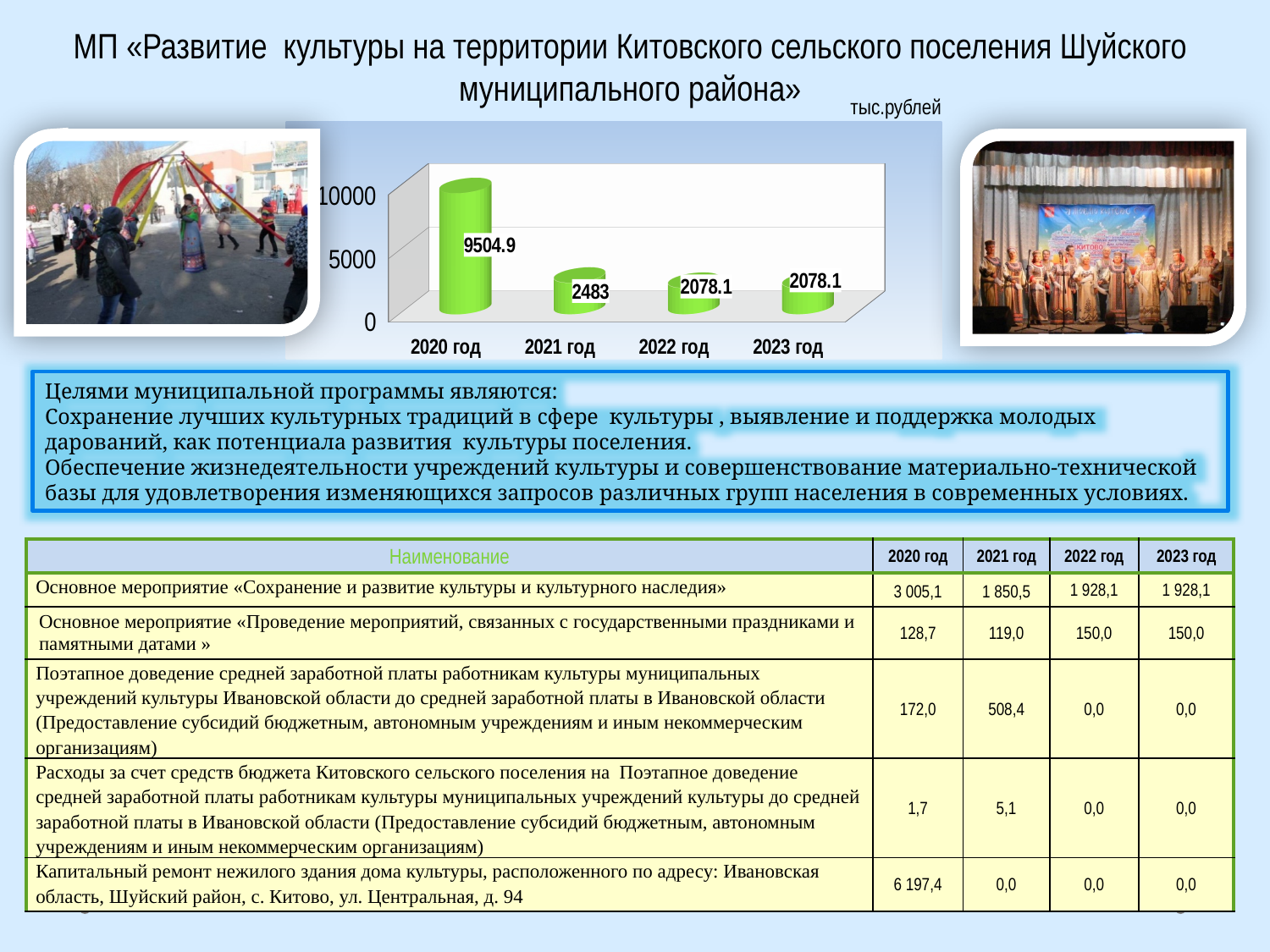
Is the value for 2020 год greater or less than 5000? greater What is the value for 2023 год on the chart? 2078.1 What unit is indicated above the chart? тыс.рублей What is the value for 2021 год on the chart? 2483 What kind of chart is shown on the slide? bar chart What is the value for 2020 год on the chart? 9504.9 Which is larger, the value for 2021 год or the value for 2022 год? 2021 год What is the difference between the values for 2020 год and 2021 год? 7021.9 How many years are shown on the chart's x axis? 4 What is the value for 2022 год on the chart? 2078.1 What is the difference between the values for 2021 год and 2022 год? 404.9 Which year has the highest value on the chart? 2020 год